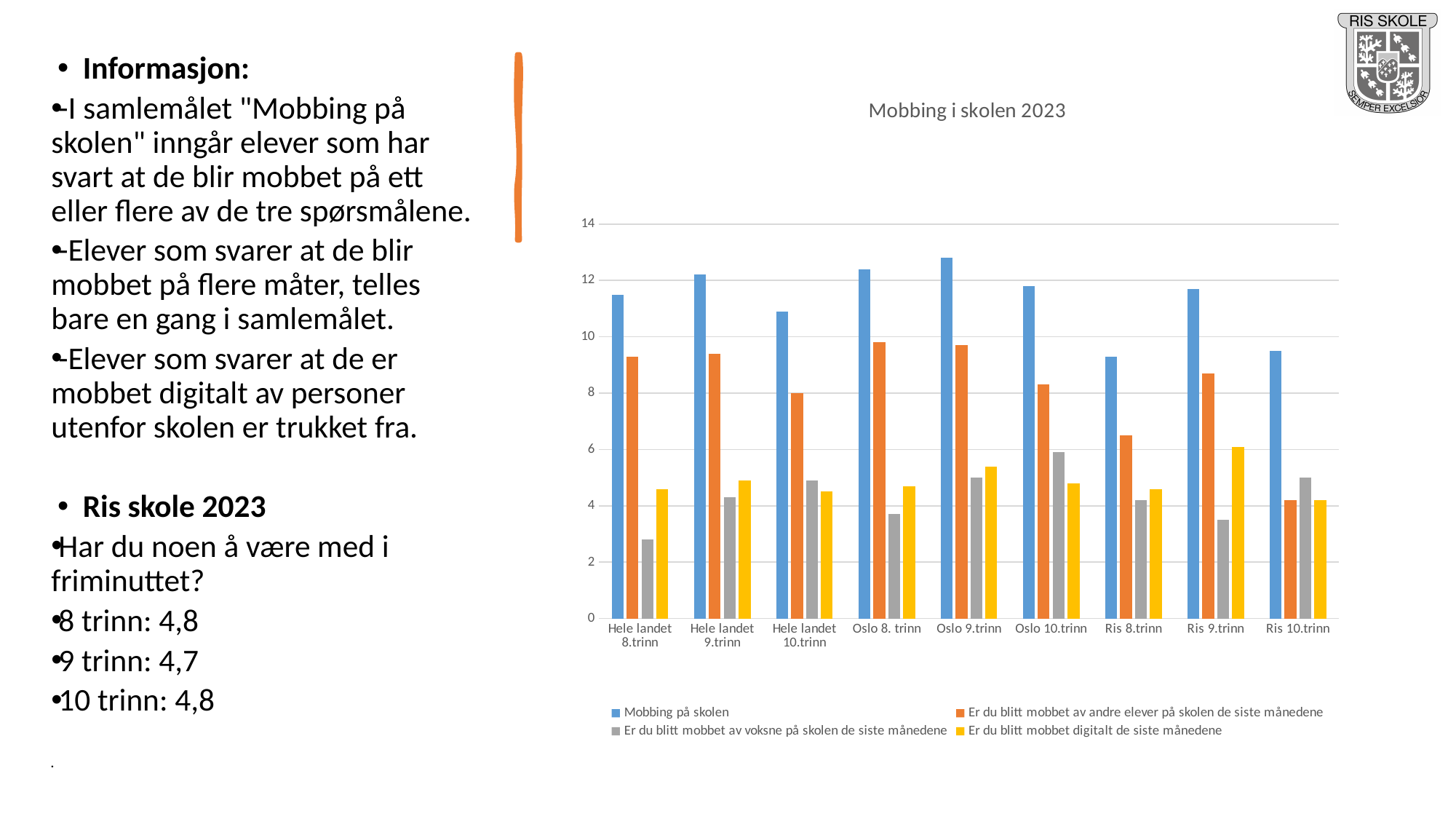
Is the value of 'Mobbing på skolen' for Hele landet 8.trinn greater or less than 10? greater How many series does the chart legend list? 4 Is the value of 'Mobbing på skolen' for Ris 8.trinn greater or less than 10? less Which category has the highest value for 'Er du blitt mobbet digitalt de siste månedene'? Ris 9.trinn Which category has the lowest value for 'Er du blitt mobbet av voksne på skolen de siste månedene'? Hele landet 8.trinn What is the title of the chart? Mobbing i skolen 2023 Is the value of 'Mobbing på skolen' for Oslo 9.trinn greater or less than 12? greater How many categories are shown along the x axis of the chart? 9 Which is larger for 'Mobbing på skolen': Oslo 8. trinn or Ris 8.trinn? Oslo 8. trinn What kind of chart is shown on the slide? bar chart